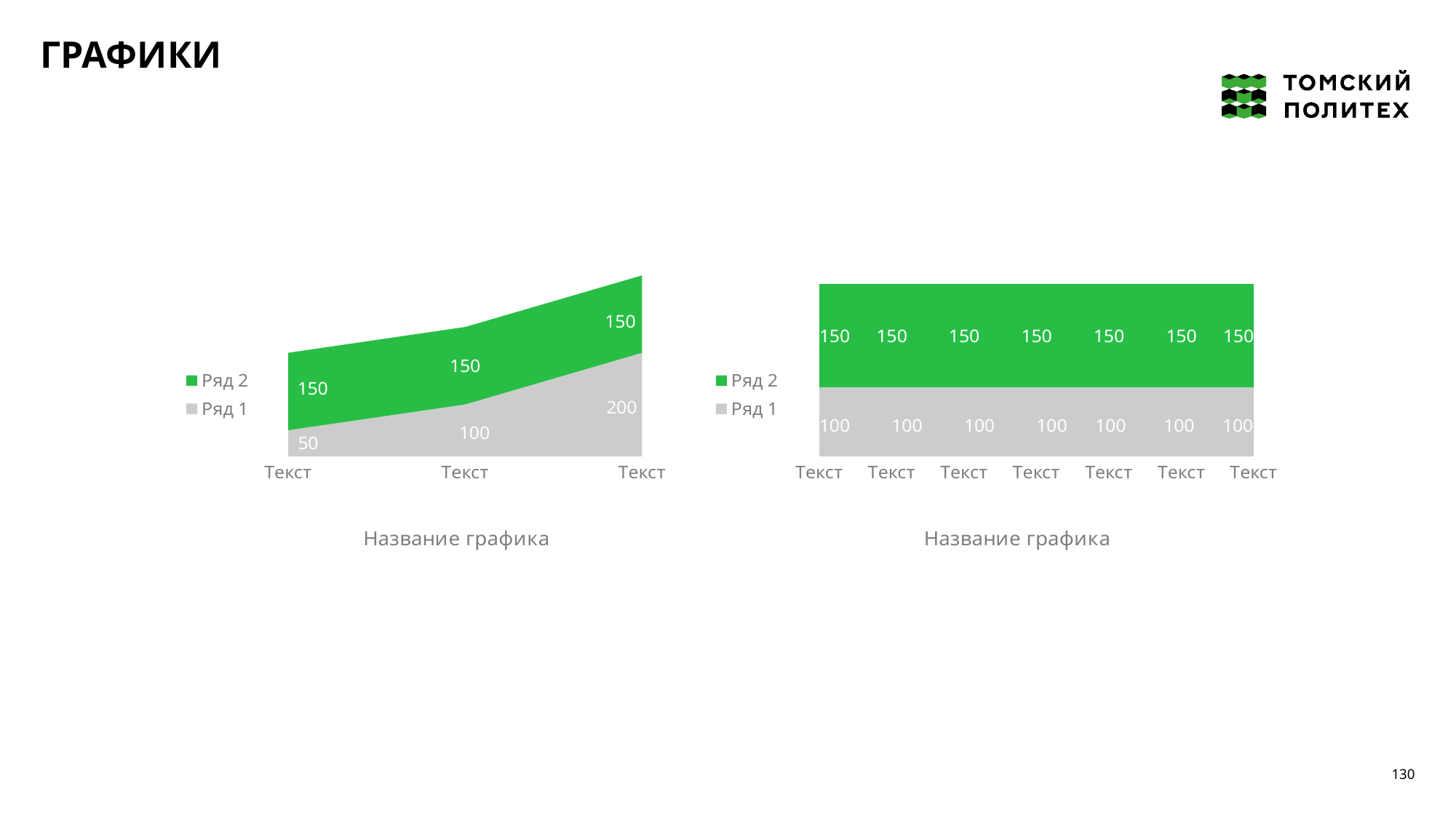
On the left chart, what is the total of the stacked values at the rightmost category? 350 On the left chart, what is the difference between the Ряд 1 value at the rightmost category and at the leftmost category? 150 On the left chart, what kind of chart is it? area chart On the left chart, what is the value of Ряд 1 at the leftmost category? 50 On the right chart, how many categories are shown on the x axis? 7 On the left chart, how many series does the legend list? 2 On the left chart, how many categories are shown on the x axis? 3 On the left chart, do the values of Ряд 1 rise or fall from left to right along the x axis? rise On the right chart, which series has the larger value at the last category, Ряд 1 or Ряд 2? Ряд 2 On the right chart, what is the total of the stacked values at the first category? 250 On the right chart, what is the value of Ряд 2 at the first category? 150 On the left chart, what is the value of Ряд 1 at the rightmost category? 200